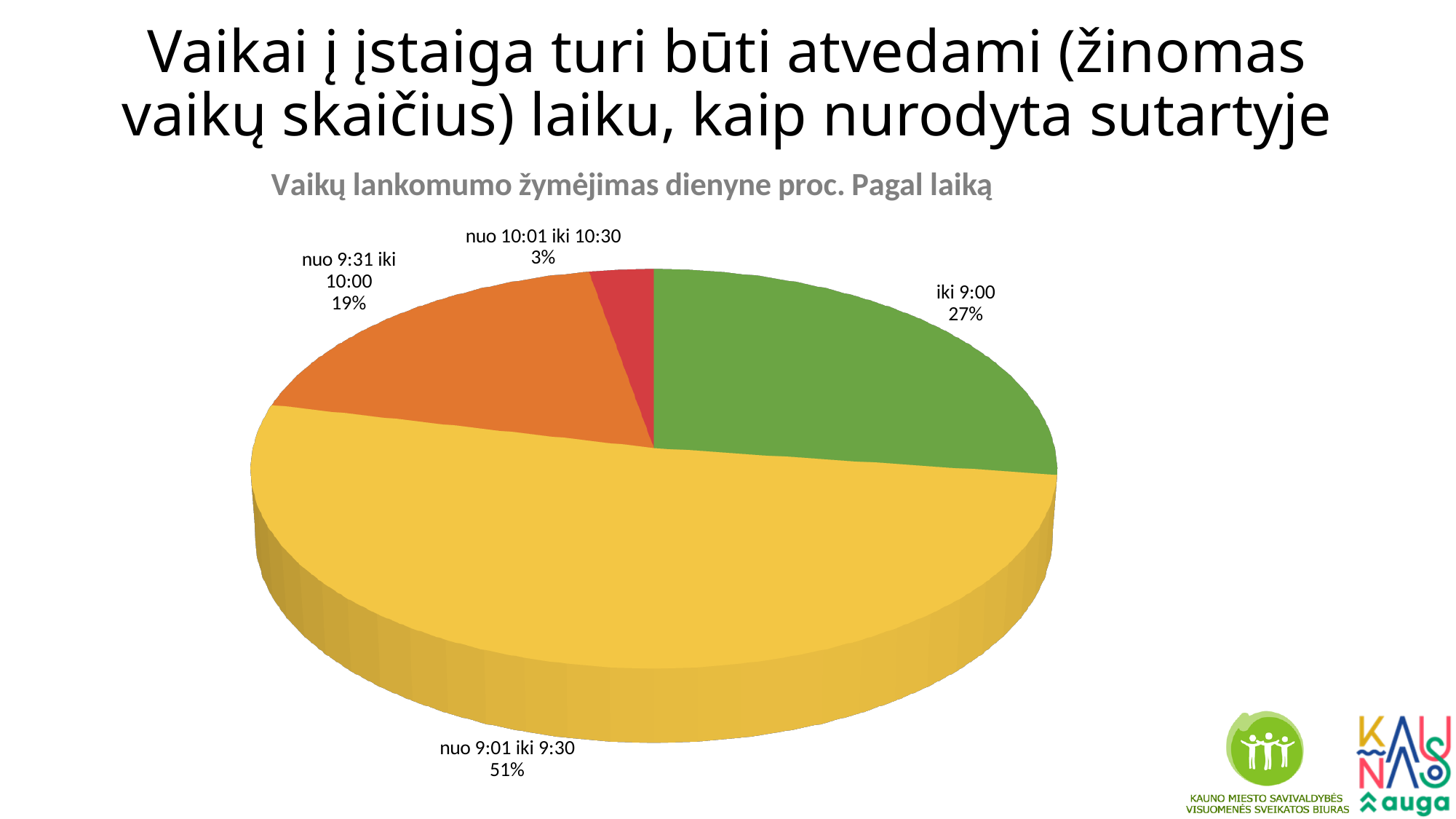
Which is larger, the share for "iki 9:00" or the share for "nuo 9:31 iki 10:00"? iki 9:00 What is the value shown for "nuo 10:01 iki 10:30"? 3% What share of the pie does the "nuo 9:01 iki 9:30" slice represent? 51% What is the title of the chart? Vaikų lankomumo žymėjimas dienyne proc. Pagal laiką Which category has the largest share of the pie? nuo 9:01 iki 9:30 What is the value shown for "iki 9:00"? 27% What kind of chart is shown on the slide? pie chart What colour is the "iki 9:00" slice? green What is the value shown for "nuo 9:31 iki 10:00"? 19% Which category has the smallest share of the pie? nuo 10:01 iki 10:30 What is the difference in percentage points between "nuo 9:01 iki 9:30" and "iki 9:00"? 24 How many slices does the pie chart have? 4